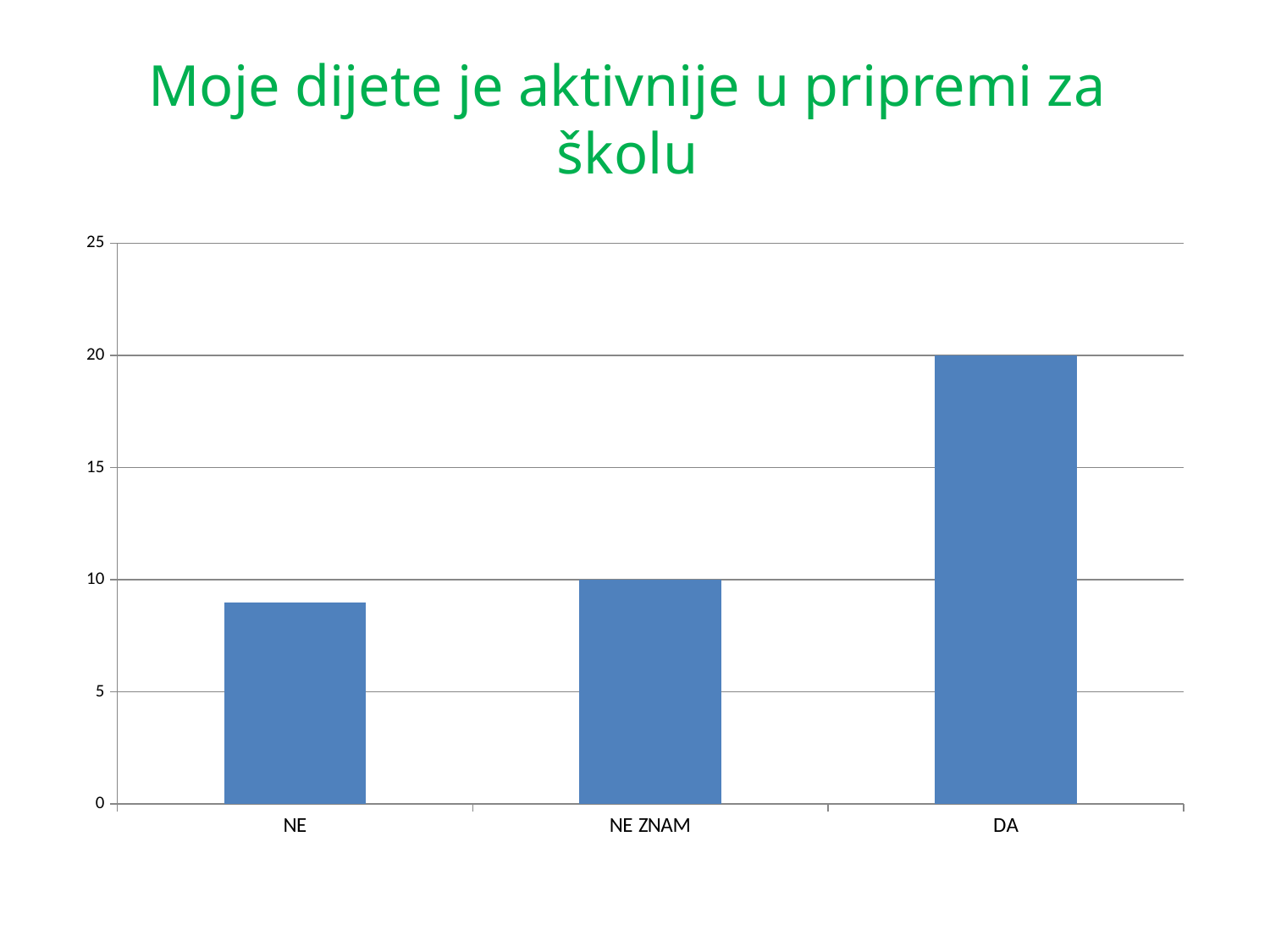
Which is larger, the value for DA or the value for NE? DA What is the title of the slide? Moje dijete je aktivnije u pripremi za školu What kind of chart is shown on the slide? bar chart Is the value for DA greater or less than 15? greater What is the value for DA? 20 Do the values rise or fall from left to right along the x axis? rise How many categories are shown on the x axis? 3 What is the difference between the values for DA and NE ZNAM? 10 Is the value for NE greater or less than 10? less Which category has the lowest value? NE What is the value for NE ZNAM? 10 Which category has the highest value? DA